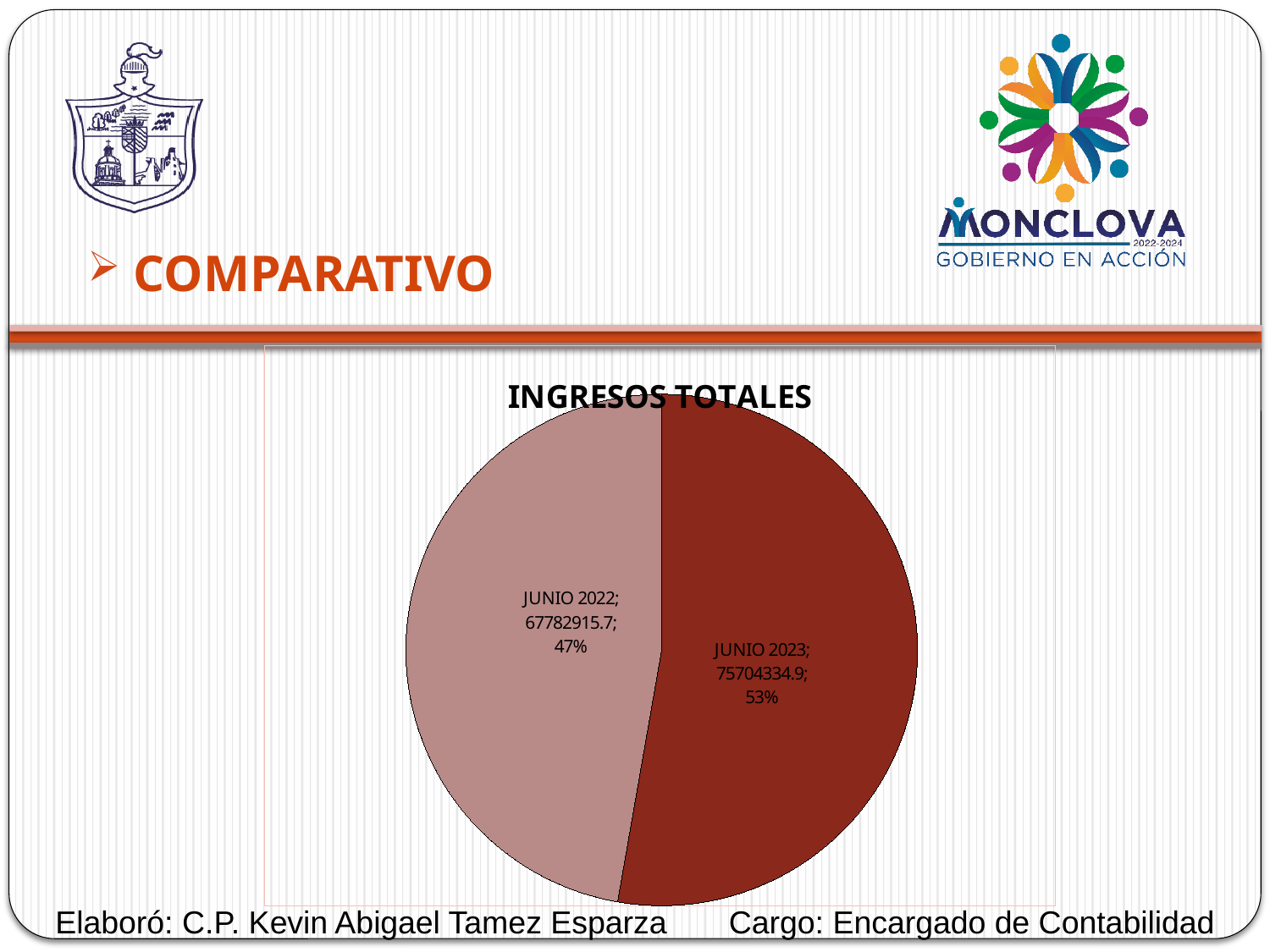
What kind of chart is shown on the slide? pie chart What is the title of the chart? INGRESOS TOTALES What is the value for JUNIO 2022? 67782915.7 Which is larger, the value for JUNIO 2022 or JUNIO 2023? JUNIO 2023 What share of the pie does JUNIO 2022 represent? 47% How many slices does the pie chart have? 2 What is the total of the two values shown in the pie chart? 143487250.6 What is the value for JUNIO 2023? 75704334.9 Which slice is the largest? JUNIO 2023 What share of the pie does JUNIO 2023 represent? 53% What is the difference between the values for JUNIO 2023 and JUNIO 2022? 7921419.2 Which slice is the smallest? JUNIO 2022